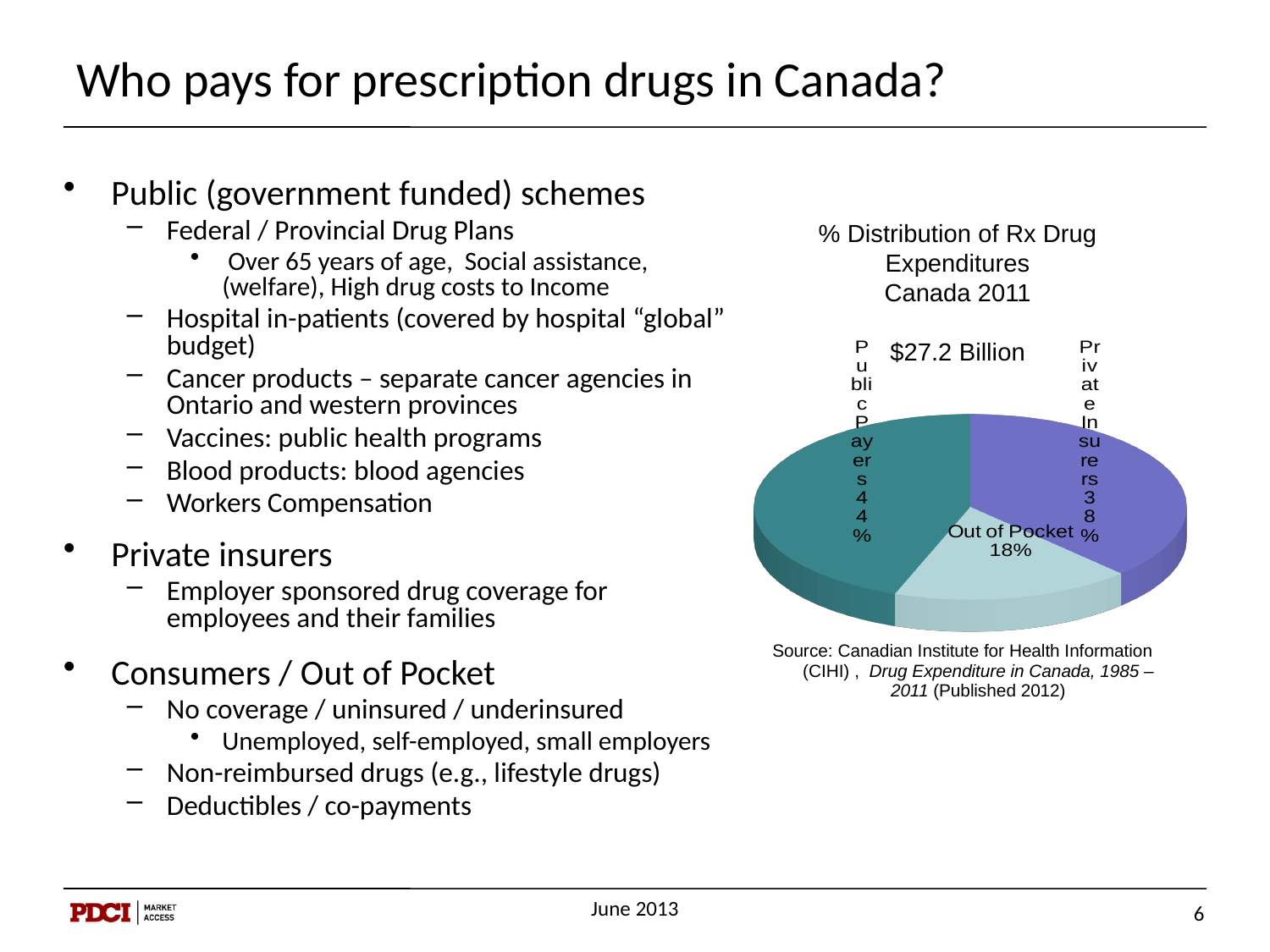
What share of Rx drug expenditures is Out of Pocket? 18% What total dollar amount of Rx drug expenditures is shown on the chart? $27.2 Billion What is the difference in percentage points between the Private Insurers share and the Out of Pocket share? 20 percentage points What is the difference in percentage points between the Public Payers share and the Private Insurers share? 6 percentage points What share of Rx drug expenditures is attributed to Public Payers? 44% What is the title of the chart? % Distribution of Rx Drug Expenditures Canada 2011 What kind of chart is shown on the slide? Pie chart How many slices does the pie chart have? 3 What share of Rx drug expenditures is attributed to Private Insurers? 38% Which payer category has the smallest share of the pie? Out of Pocket Which is larger, the Private Insurers share or the Out of Pocket share? Private Insurers Which payer category has the largest share of the pie? Public Payers